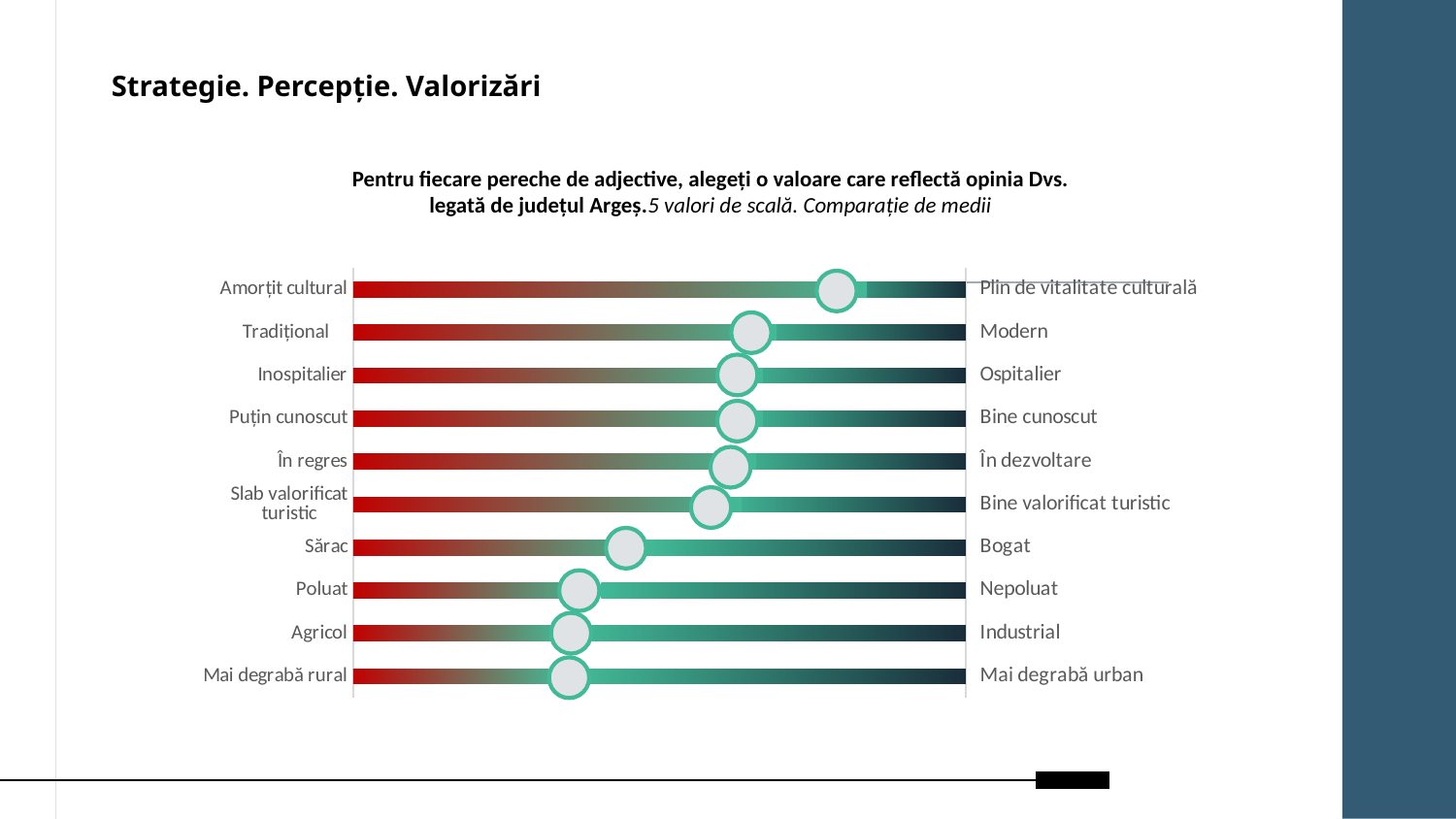
How many scale values does the chart subtitle say were used? 5 How many adjective pairs are plotted on the chart? 10 Is the marker for Amorțit cultural – Plin de vitalitate culturală further right than the marker for În regres – În dezvoltare? Yes What is the left-hand adjective paired with 'Modern' on the chart? Tradițional Is the marker for the pair Tradițional – Modern positioned further right than the marker for Sărac – Bogat? Yes Which marker is closer to the right-hand pole: Slab valorificat turistic – Bine valorificat turistic or Poluat – Nepoluat? Slab valorificat turistic – Bine valorificat turistic What is the right-hand adjective paired with 'Sărac' on the chart? Bogat Which adjective pair has its marker positioned furthest to the right, closest to the positive pole? Amorțit cultural – Plin de vitalitate culturală